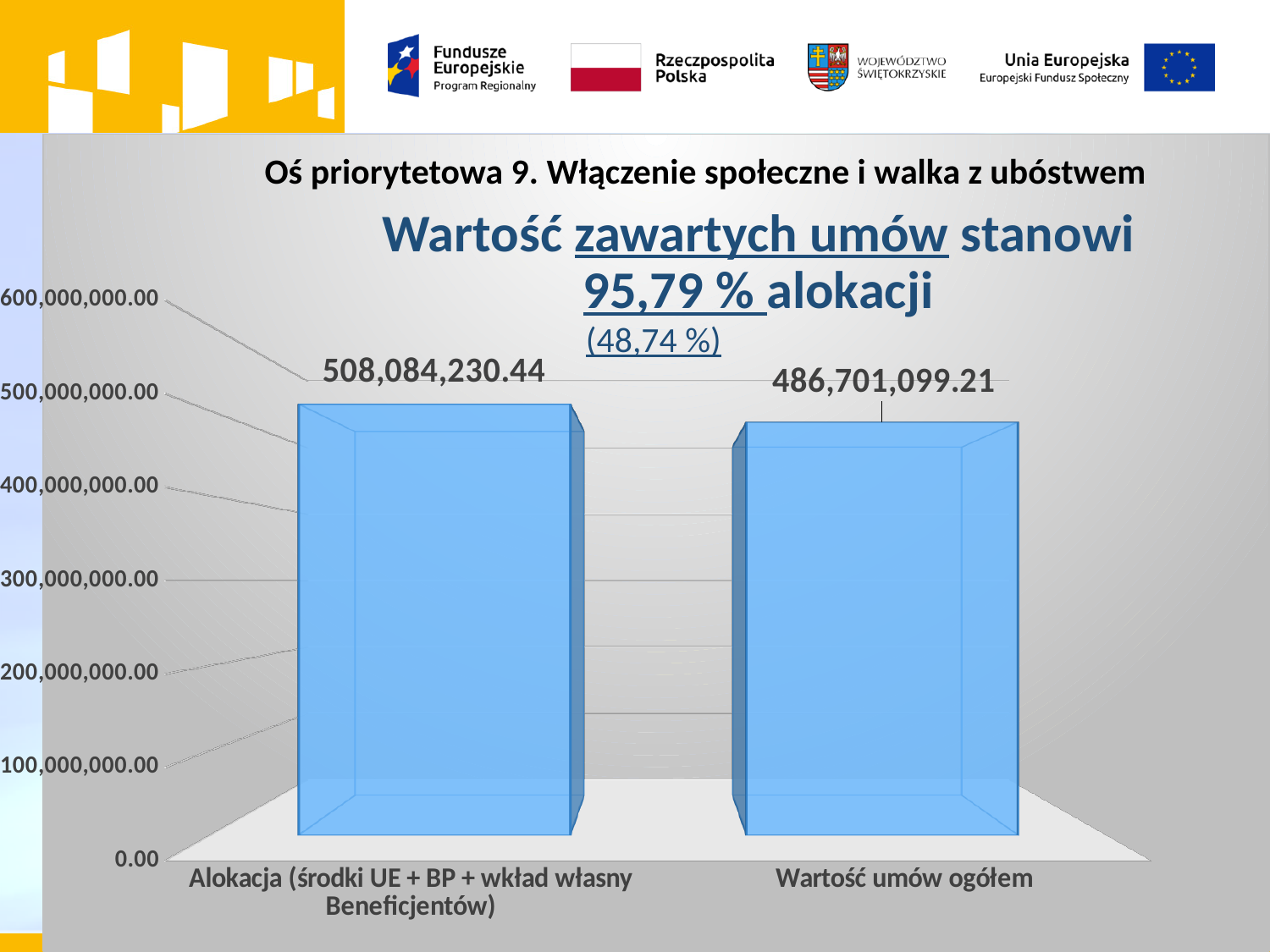
Which category has the lowest value? Wartość umów ogółem What is the value for Alokacja (środki UE + BP + wkład własny Beneficjentów)? 508,084,230.44 What is the difference between the value for Alokacja (środki UE + BP + wkład własny Beneficjentów) and the value for Wartość umów ogółem? 21,383,131.23 What kind of chart is shown on the slide? bar chart Is the value for Alokacja (środki UE + BP + wkład własny Beneficjentów) greater or less than 500,000,000.00? greater Is the value for Wartość umów ogółem greater or less than 500,000,000.00? less What is the highest value shown on the vertical axis of the chart? 600,000,000.00 What percentage of the allocation does the value of concluded contracts represent, according to the chart title? 95,79 % How many bars are shown in the chart? 2 Which is larger: the value for Alokacja (środki UE + BP + wkład własny Beneficjentów) or the value for Wartość umów ogółem? Alokacja (środki UE + BP + wkład własny Beneficjentów) What is the value for Wartość umów ogółem? 486,701,099.21 Which category has the highest value? Alokacja (środki UE + BP + wkład własny Beneficjentów)